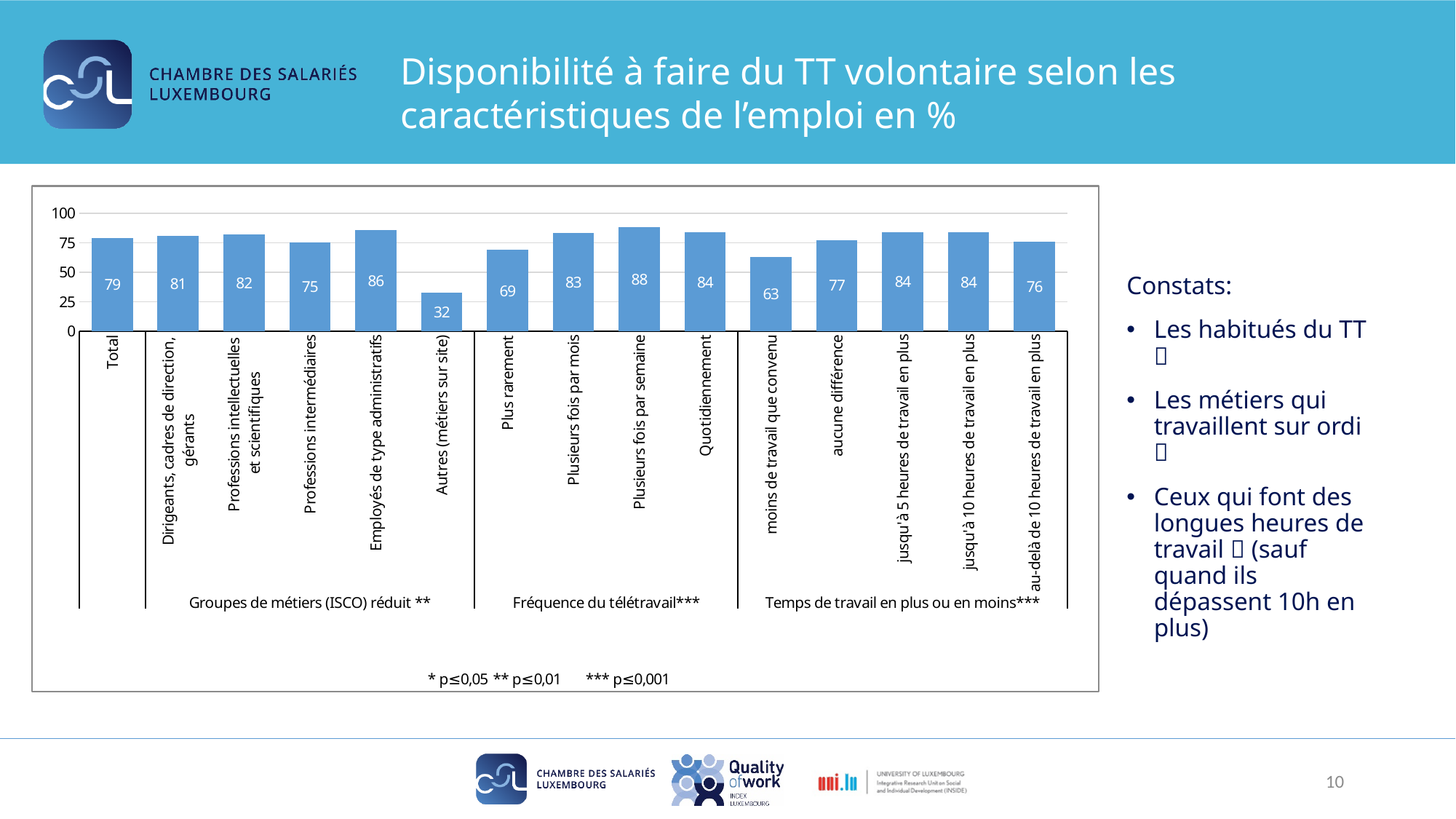
What is the value for Total? 79 What is the value for moins de travail que convenu? 63 What kind of chart is shown on the slide? bar chart Is the value for Autres (métiers sur site) greater or less than 50? less What is the difference between the values for Employés de type administratifs and Professions intermédiaires? 11 Which category has the lowest value? Autres (métiers sur site) Which is larger, the value for Plus rarement or the value for Quotidiennement? Quotidiennement What is the value for Autres (métiers sur site)? 32 What are the three group labels shown beneath the category axis? Groupes de métiers (ISCO) réduit **, Fréquence du télétravail***, Temps de travail en plus ou en moins*** What is the value for Plusieurs fois par semaine? 88 Which category has the highest value? Plusieurs fois par semaine How many bars are plotted in the chart? 15